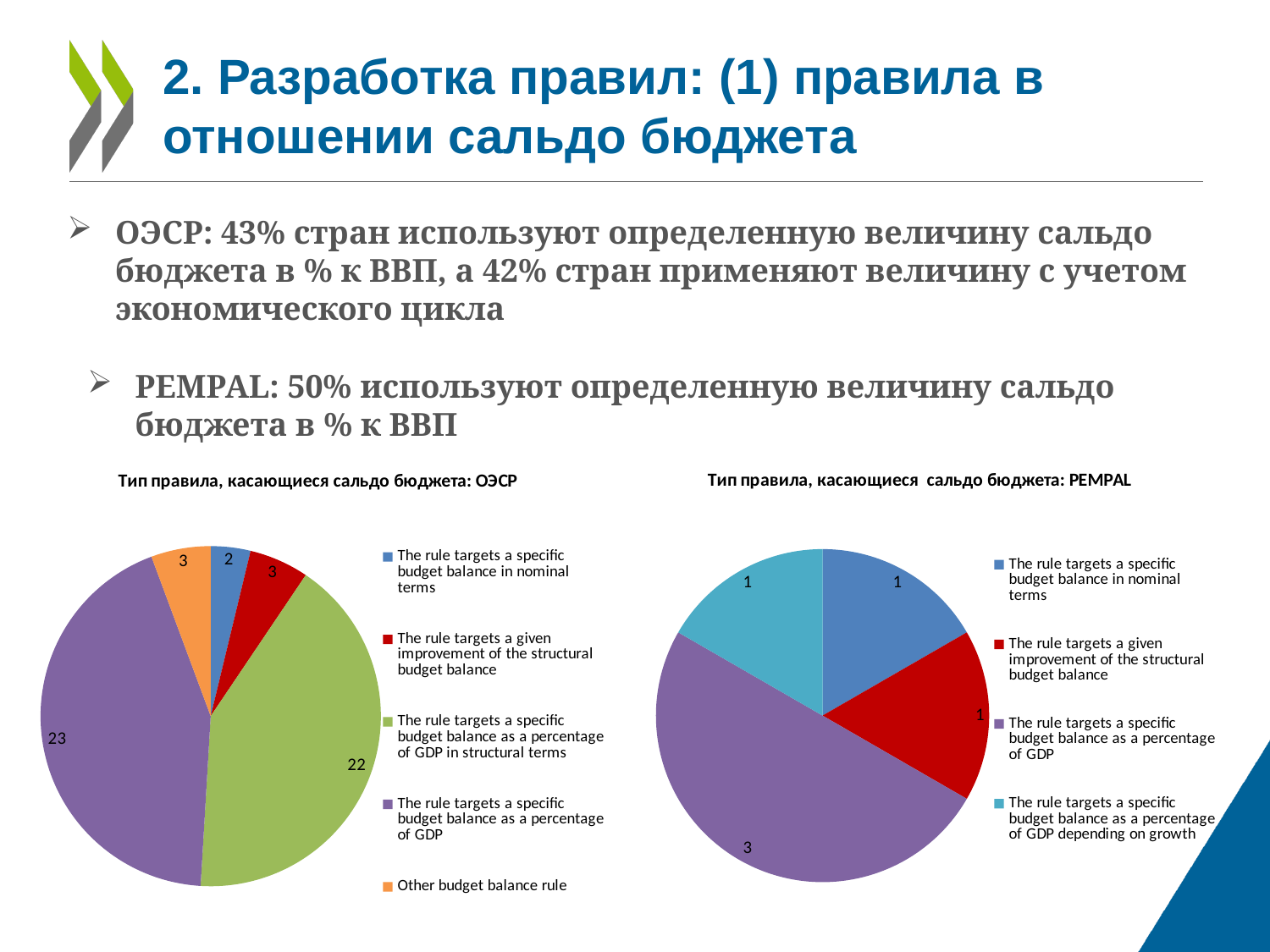
In the ОЭСР pie chart, which category has the smallest value? The rule targets a specific budget balance in nominal terms In the ОЭСР pie chart, what is the value for 'The rule targets a specific budget balance in nominal terms'? 2 In the ОЭСР pie chart, what is the difference between the value for 'percentage of GDP' (23) and 'Other budget balance rule' (3)? 20 In the PEMPAL pie chart, which category has the largest value? The rule targets a specific budget balance as a percentage of GDP In the ОЭСР pie chart, what is the value for 'The rule targets a specific budget balance as a percentage of GDP in structural terms'? 22 In the ОЭСР pie chart, how many categories does the legend list? 5 In the PEMPAL pie chart, what share of the total does 'The rule targets a specific budget balance as a percentage of GDP' represent? 50% In the PEMPAL pie chart, how many categories are shown? 4 In the ОЭСР pie chart, what is the value for 'The rule targets a specific budget balance as a percentage of GDP'? 23 In the PEMPAL pie chart, what is the value for 'The rule targets a specific budget balance as a percentage of GDP'? 3 In the PEMPAL pie chart, what is the total of all slice values? 6 What kind of chart is the 'Тип правила, касающиеся сальдо бюджета: ОЭСР' chart? pie chart